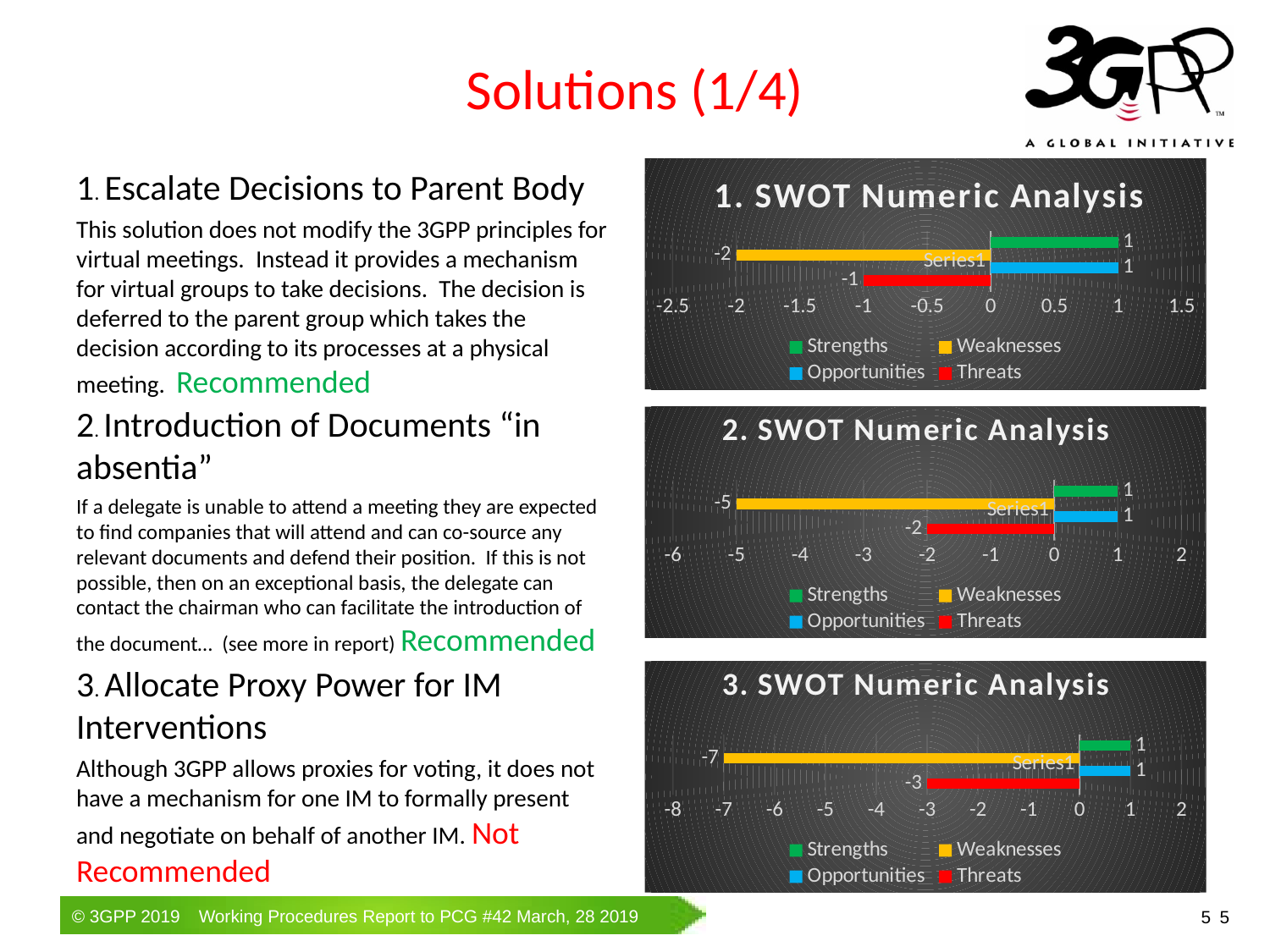
In the chart titled "2. SWOT Numeric Analysis", what is the difference between the Weaknesses value and the Threats value? 3 In the chart titled "3. SWOT Numeric Analysis", what is the value for Weaknesses? -7 In the chart titled "1. SWOT Numeric Analysis", what is the value for Weaknesses? -2 How many series does the legend list in the chart titled "1. SWOT Numeric Analysis"? 4 In the chart titled "3. SWOT Numeric Analysis", what is the value for Strengths? 1 In the chart titled "3. SWOT Numeric Analysis", which is lower, Weaknesses or Threats? Weaknesses In the chart titled "1. SWOT Numeric Analysis", what is the value for Threats? -1 In the chart titled "2. SWOT Numeric Analysis", what is the value for Weaknesses? -5 What kind of chart is the chart titled "2. SWOT Numeric Analysis"? Bar chart In the chart titled "2. SWOT Numeric Analysis", what is the value for Threats? -2 In the chart titled "3. SWOT Numeric Analysis", which series has the lowest value? Weaknesses In the chart titled "1. SWOT Numeric Analysis", what colour represents Opportunities in the legend? Blue